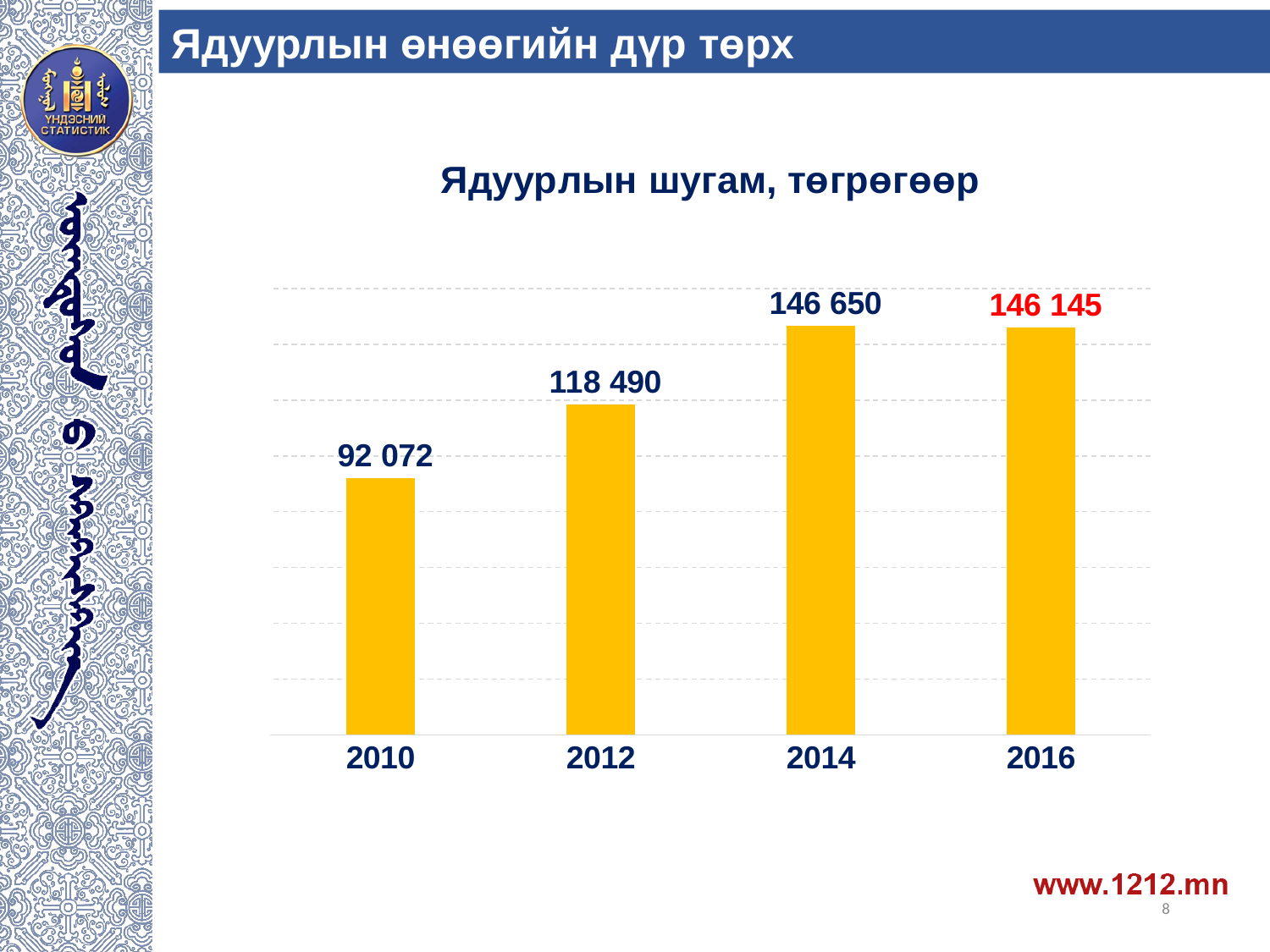
What kind of chart is shown on the slide? bar chart What is the value for 2012 in the chart? 118 490 Which is larger, the value for 2012 or the value for 2010? 2012 What is the value for 2016 in the chart? 146 145 What is the title of the chart? Ядуурлын шугам, төгрөгөөр How many years are shown on the x axis of the chart? 4 Which year has the highest value in the chart? 2014 Which year has the lowest value in the chart? 2010 What is the value for 2014 in the chart? 146 650 What is the difference between the values for 2012 and 2010? 26 418 What is the difference between the values for 2014 and 2016? 505 What is the value for 2010 in the chart? 92 072